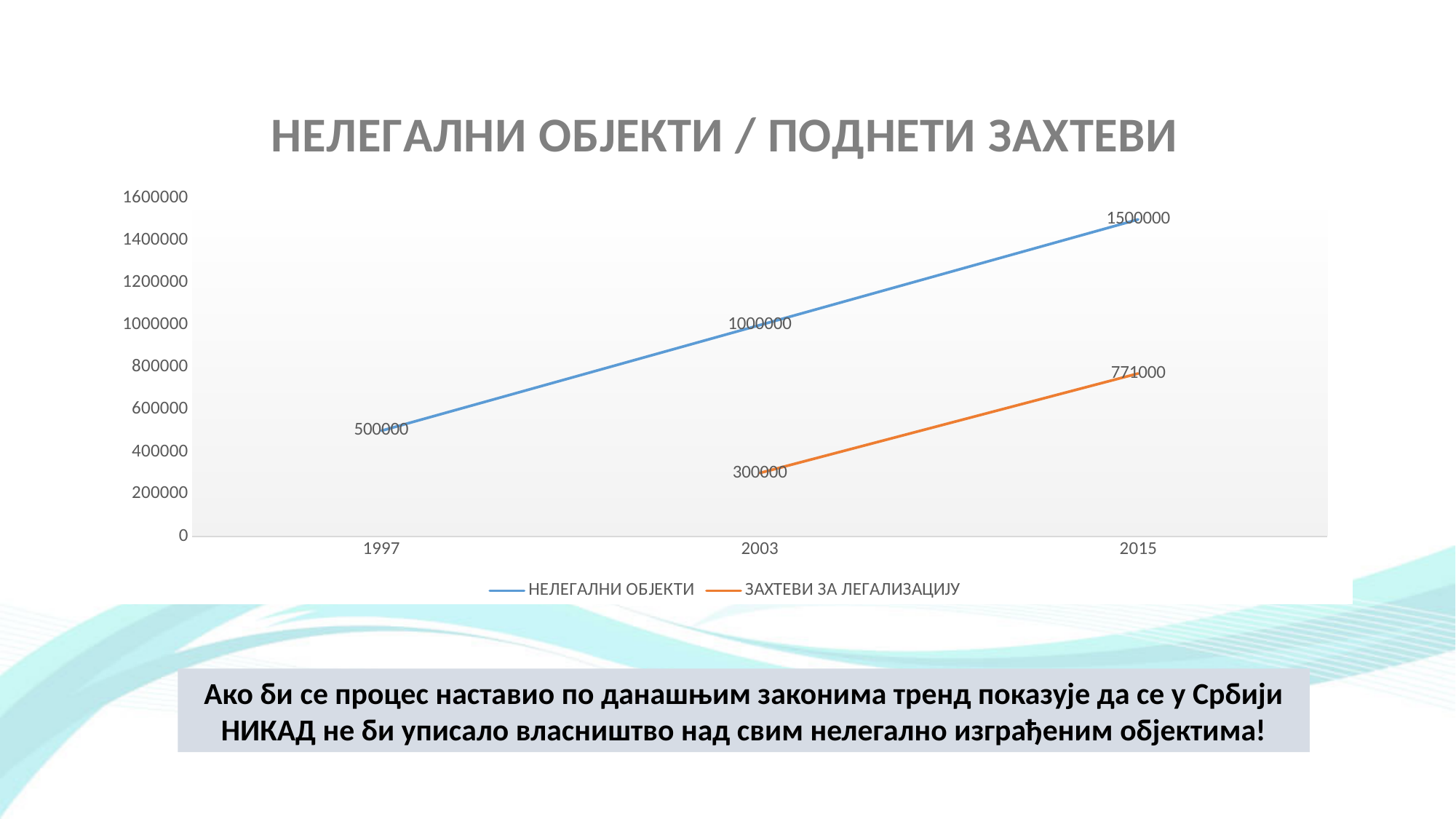
What is the value of НЕЛЕГАЛНИ ОБЈЕКТИ in 1997? 500000 What type of chart is shown on the slide? line chart What is the value of ЗАХТЕВИ ЗА ЛЕГАЛИЗАЦИЈУ in 2003? 300000 What is the value of НЕЛЕГАЛНИ ОБЈЕКТИ in 2003? 1000000 How many series does the legend list? 2 In 2003, which series has the larger value, НЕЛЕГАЛНИ ОБЈЕКТИ or ЗАХТЕВИ ЗА ЛЕГАЛИЗАЦИЈУ? НЕЛЕГАЛНИ ОБЈЕКТИ By how much did НЕЛЕГАЛНИ ОБЈЕКТИ increase from 1997 to 2015? 1000000 What is the difference between НЕЛЕГАЛНИ ОБЈЕКТИ and ЗАХТЕВИ ЗА ЛЕГАЛИЗАЦИЈУ in 2015? 729000 What is the value of ЗАХТЕВИ ЗА ЛЕГАЛИЗАЦИЈУ in 2015? 771000 Do the values of ЗАХТЕВИ ЗА ЛЕГАЛИЗАЦИЈУ rise or fall from 2003 to 2015? rise What is the value of НЕЛЕГАЛНИ ОБЈЕКТИ in 2015? 1500000 How many years are shown on the x axis? 3